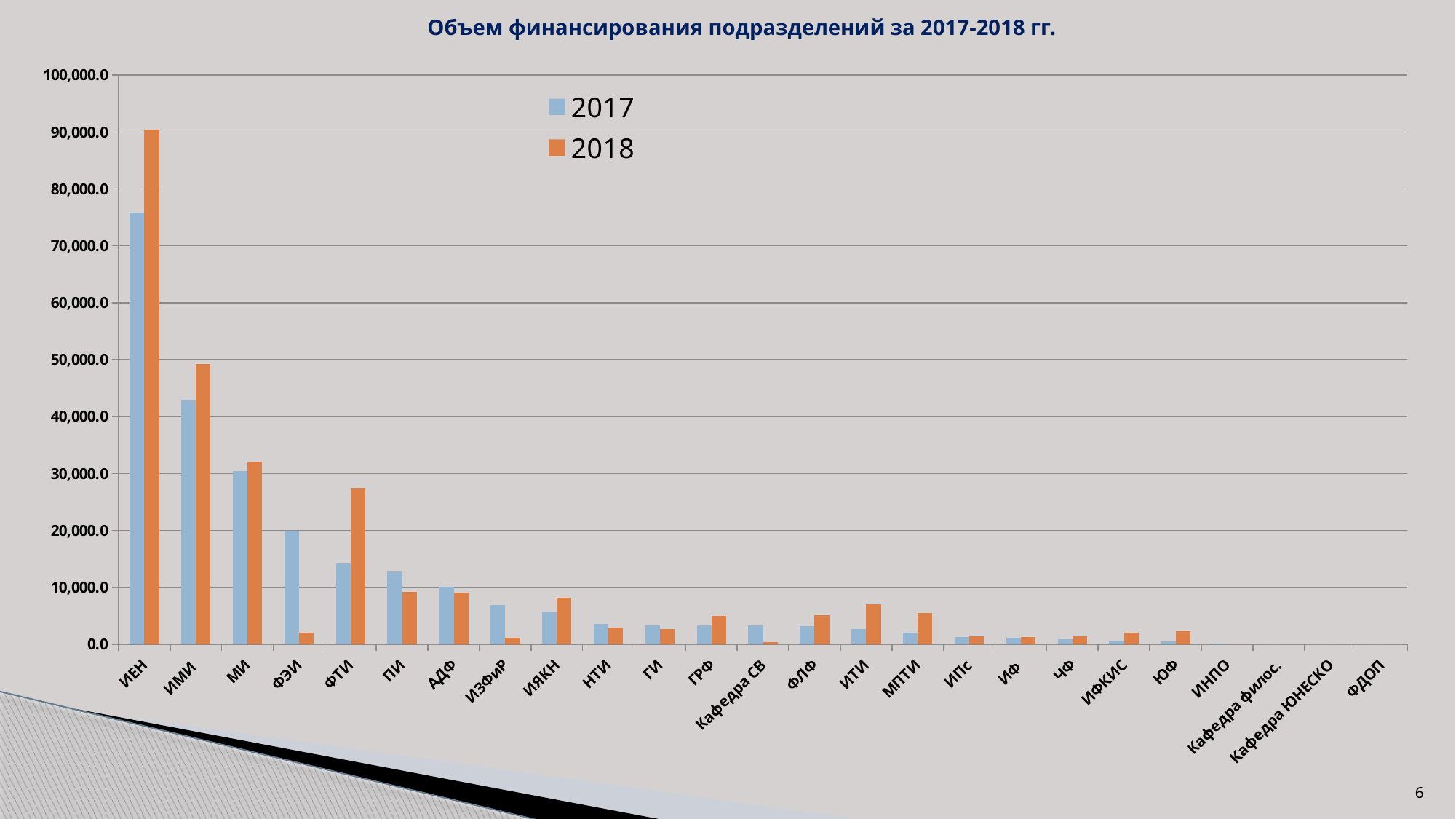
How many series does the legend list? 2 Is the 2017 value for ИМИ greater or less than 50,000.0? less For ИЕН, which is larger: the 2017 value or the 2018 value? 2018 Do the 2017 values generally rise or fall from left to right along the x axis? fall Which category has the highest value for 2017? ИЕН How many categories are shown on the x axis? 25 Is the 2018 value for ИЕН greater or less than 80,000.0? greater For ФЭИ, which is larger: the 2017 value or the 2018 value? 2017 For ФТИ, which is larger: the 2017 value or the 2018 value? 2018 What kind of chart is shown on the slide? bar chart Which category has the highest value for 2018? ИЕН Which series are listed in the legend? 2017 and 2018